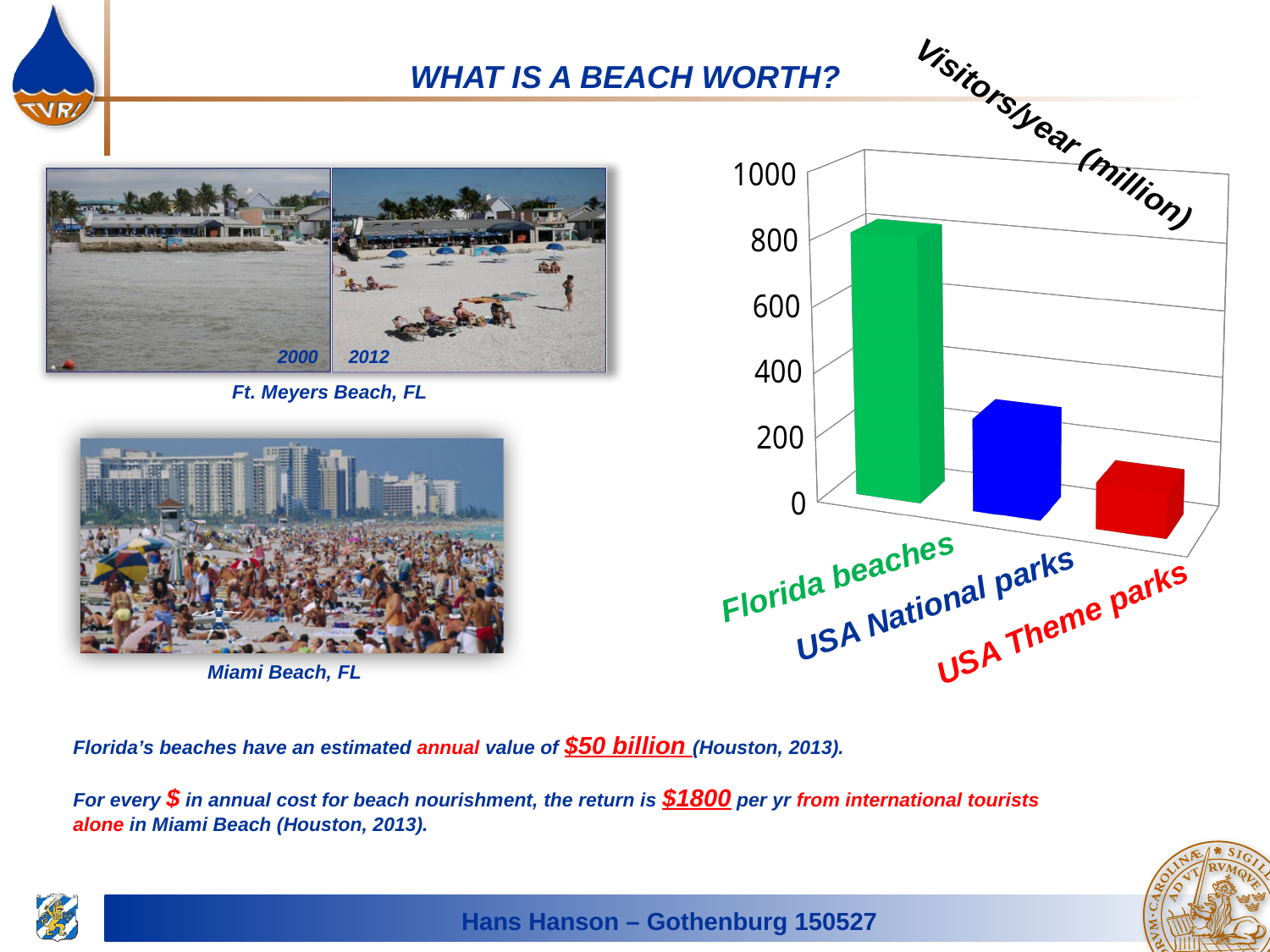
Which has more visitors per year, Florida beaches or USA National parks? Florida beaches Is the value for USA National parks greater or less than 600? less What is the label of the vertical axis of the chart? Visitors/year (million) Which category has the highest number of visitors per year? Florida beaches What is the highest value shown on the vertical axis of the chart? 1000 Which category has the lowest number of visitors per year? USA Theme parks What kind of chart is shown on the slide? bar chart Which has more visitors per year, USA National parks or USA Theme parks? USA National parks How many categories are plotted in the chart? 3 Is the value for Florida beaches greater or less than 600? greater What colour is the bar for Florida beaches? green Is the value for USA Theme parks greater or less than 400? less